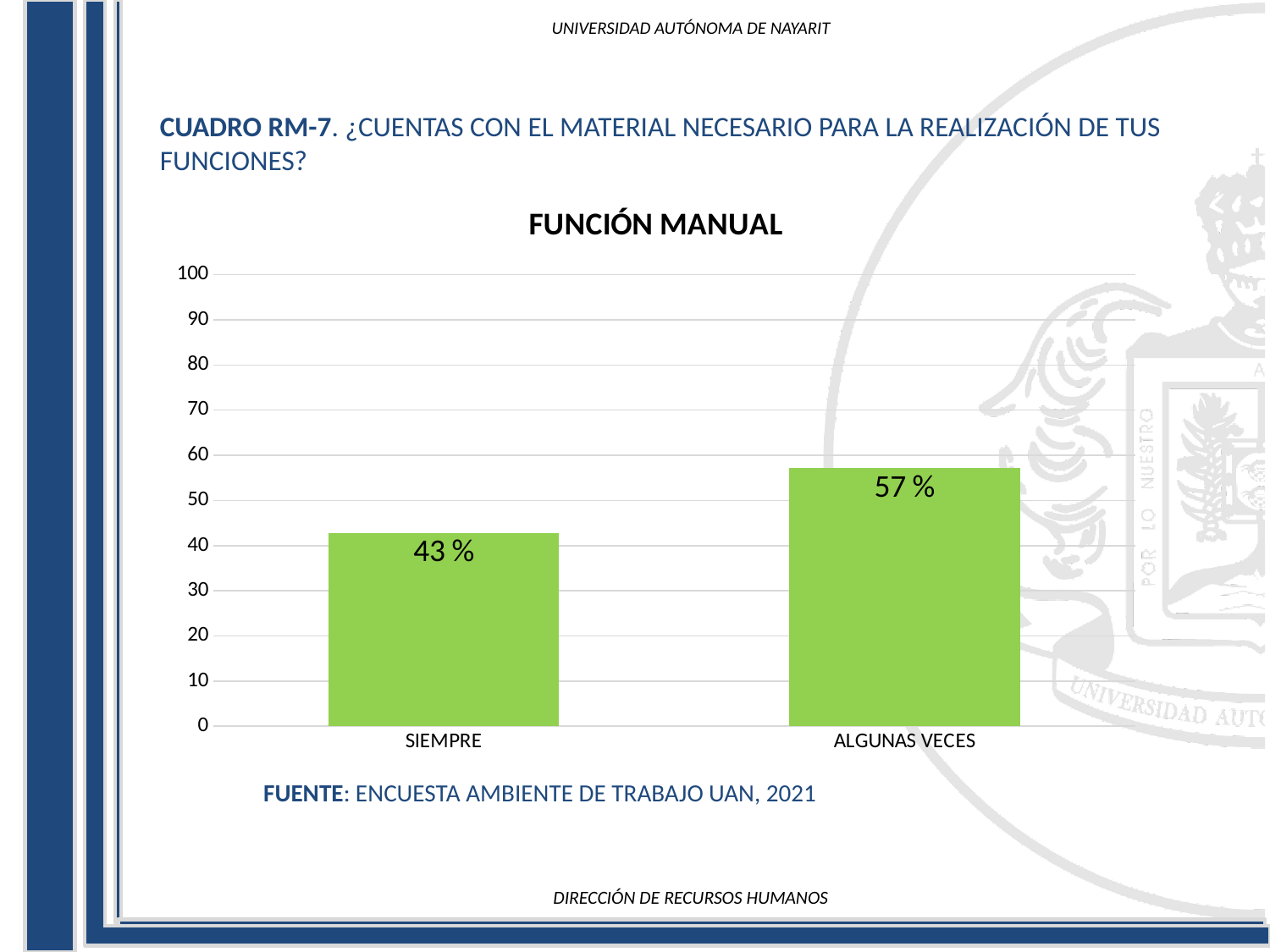
What is the title of the chart? FUNCIÓN MANUAL Which category has the lowest value? SIEMPRE How many categories are shown on the x axis? 2 Which category has the highest value? ALGUNAS VECES What colour are the bars in the chart? green What is the value for ALGUNAS VECES? 57 % What is the value for SIEMPRE? 43 % Is the value for SIEMPRE greater or less than 50? less Which is larger, the value for SIEMPRE or the value for ALGUNAS VECES? ALGUNAS VECES What is the difference between the values for ALGUNAS VECES and SIEMPRE? 14 % Is the value for ALGUNAS VECES greater or less than 50? greater What kind of chart is shown on the slide? bar chart